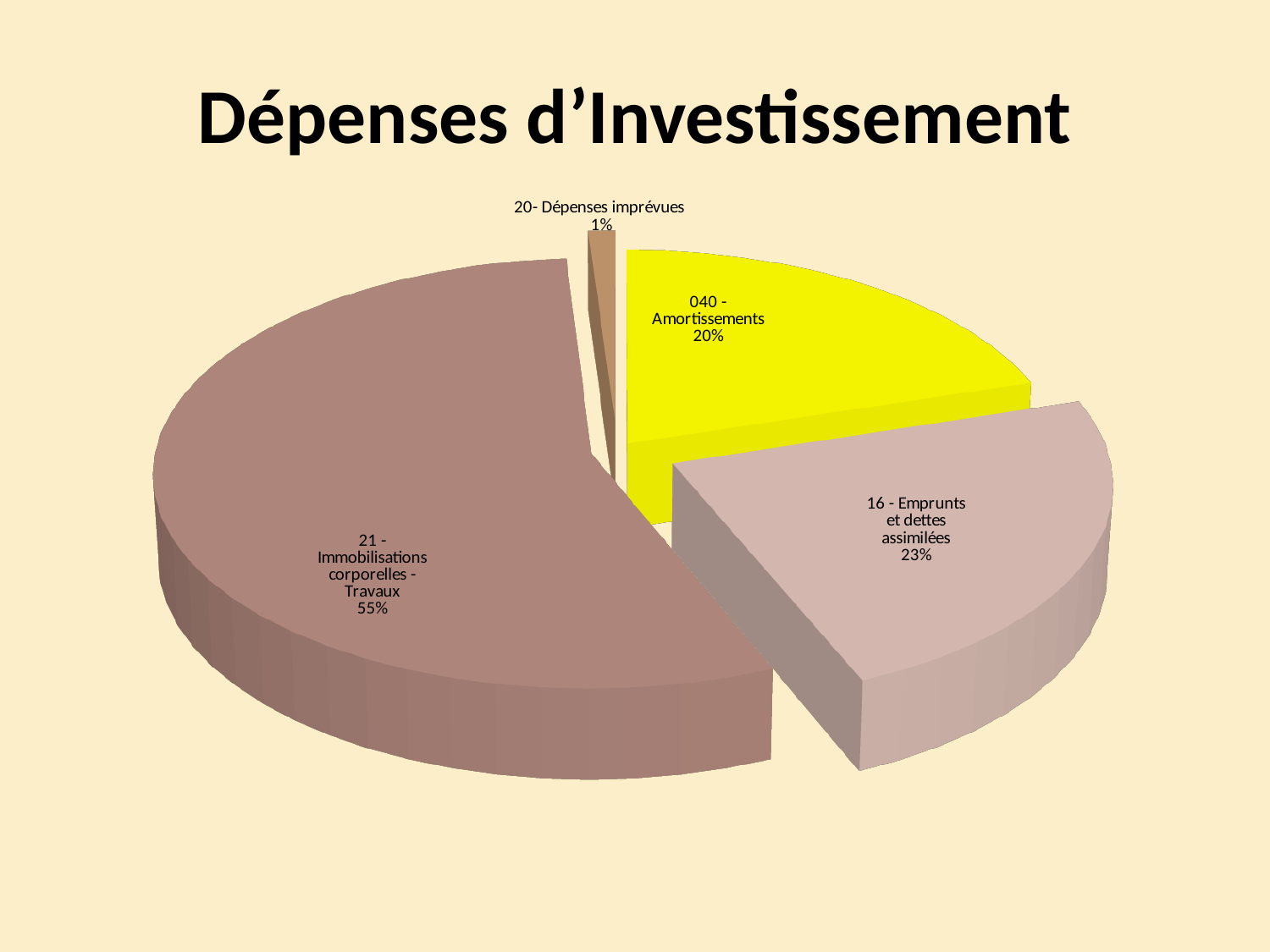
What kind of chart is shown on the slide? Pie chart Which category has the smallest slice of the pie? 20- Dépenses imprévues Which is larger: the share for "16 - Emprunts et dettes assimilées" or the share for "040 - Amortissements"? 16 - Emprunts et dettes assimilées How many slices does the pie chart have? 4 What share of the pie does "040 - Amortissements" represent? 20% What share of the pie does "21 - Immobilisations corporelles - Travaux" represent? 55% Which category has the largest slice of the pie? 21 - Immobilisations corporelles - Travaux What share of the pie does "16 - Emprunts et dettes assimilées" represent? 23% What colour is the slice for "040 - Amortissements"? Yellow What is the title of the slide containing the pie chart? Dépenses d'Investissement What is the difference in percentage points between "21 - Immobilisations corporelles - Travaux" and "16 - Emprunts et dettes assimilées"? 32